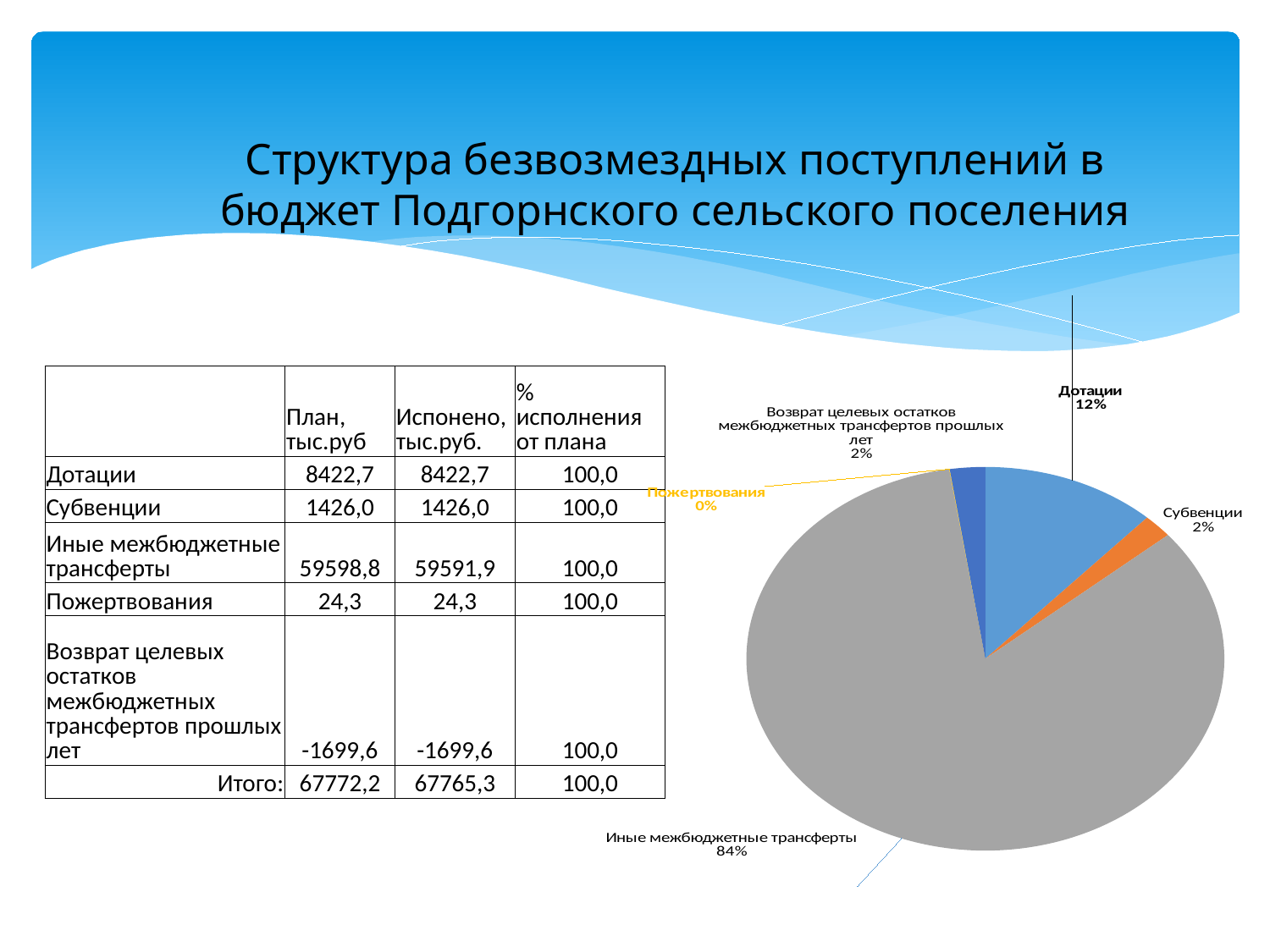
What share of the pie does Иные межбюджетные трансферты have? 84% Which category has the smallest slice of the pie? Пожертвования Which is larger in the pie chart, Дотации or Субвенции? Дотации What colour is the Иные межбюджетные трансферты slice? grey What is the difference in percentage points between the Иные межбюджетные трансферты slice and the Дотации slice? 72 What share of the pie does Возврат целевых остатков межбюджетных трансфертов прошлых лет have? 2% What share of the pie does Дотации have? 12% What kind of chart is shown on the slide? pie chart Which category has the largest slice of the pie? Иные межбюджетные трансферты How many slices are labelled in the pie chart? 5